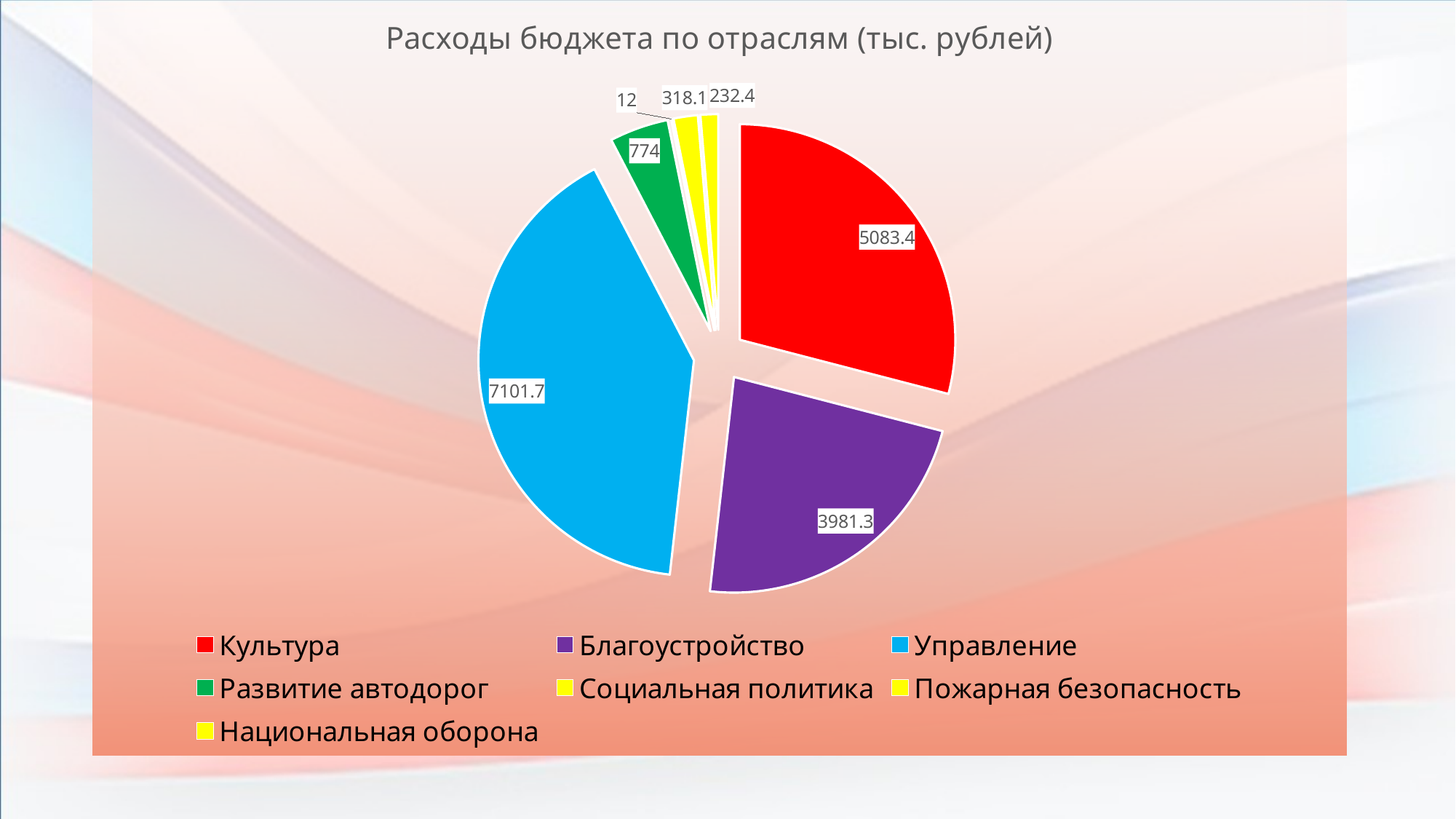
What type of chart is shown on the slide? pie chart What is the difference between the values for Управление and Культура? 2018.3 What is the smallest value labelled on the pie? 12 What colour is the slice for Благоустройство? purple What is the value for Развитие автодорог? 774 What is the value for Культура? 5083.4 Which is larger, the value for Культура or the value for Благоустройство? Культура Which category has the largest share of the pie? Управление How many categories does the legend list? 7 What is the title of the chart? Расходы бюджета по отраслям (тыс. рублей) What is the value for Благоустройство? 3981.3 What is the value for Управление? 7101.7